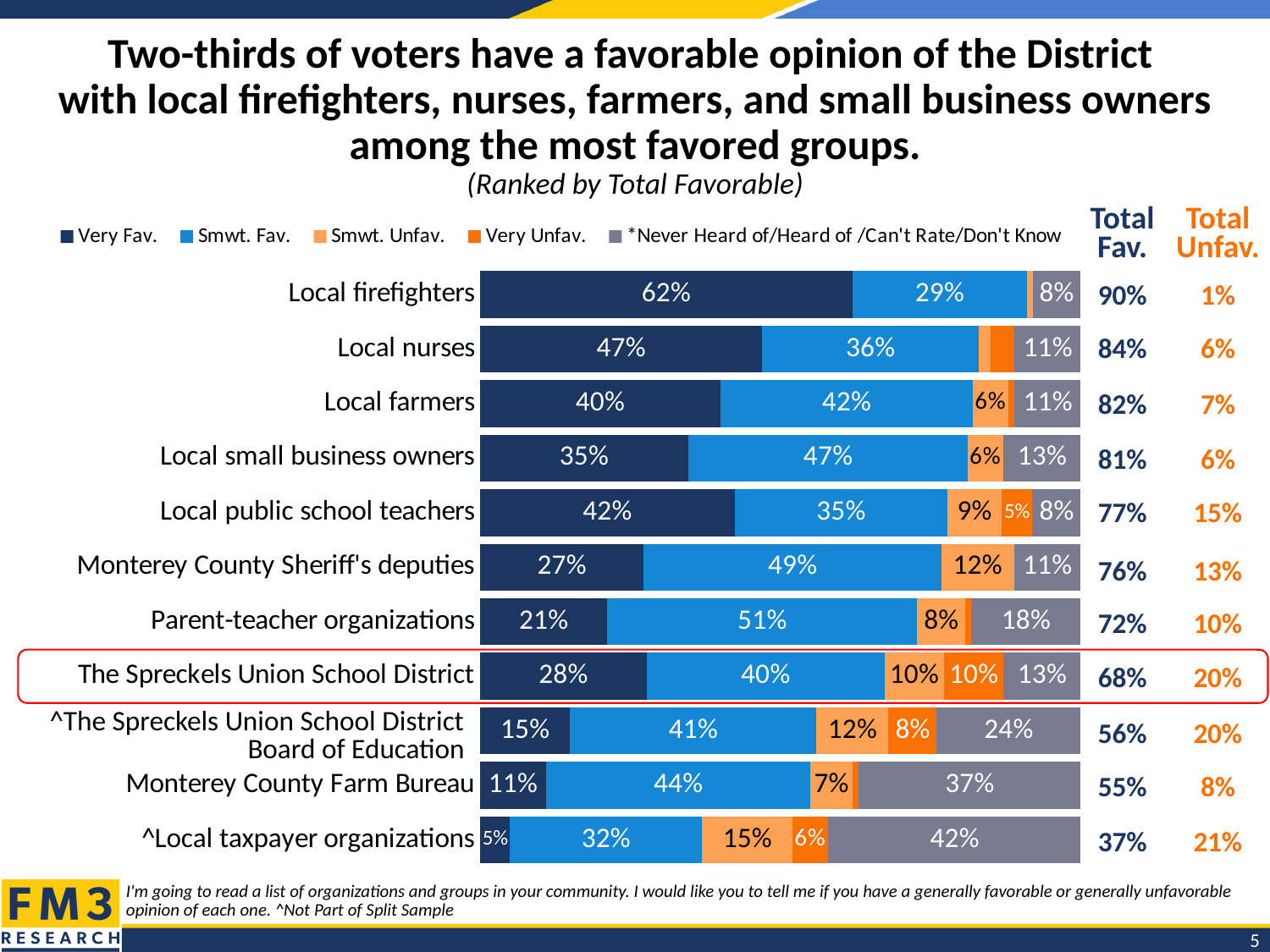
Which row of the chart is highlighted with a red outline? The Spreckels Union School District What is the Smwt. Fav. value for Parent-teacher organizations? 51% What is the difference in Total Fav. between Local firefighters and The Spreckels Union School District? 22 percentage points Which group has the highest Very Fav. percentage? Local firefighters What is the *Never Heard of/Heard of/Can't Rate/Don't Know value for Monterey County Farm Bureau? 37% Which has a larger Smwt. Fav. value, Local farmers or Local nurses? Local farmers What is the Total Unfav. value for Local public school teachers? 15% What kind of chart is shown on the slide? Stacked bar chart What percentage of voters have a Very Favorable opinion of Local firefighters? 62% How many series does the legend list? 5 How many groups or organizations are shown in the chart? 11 Which group has the lowest Total Fav. percentage? ^Local taxpayer organizations